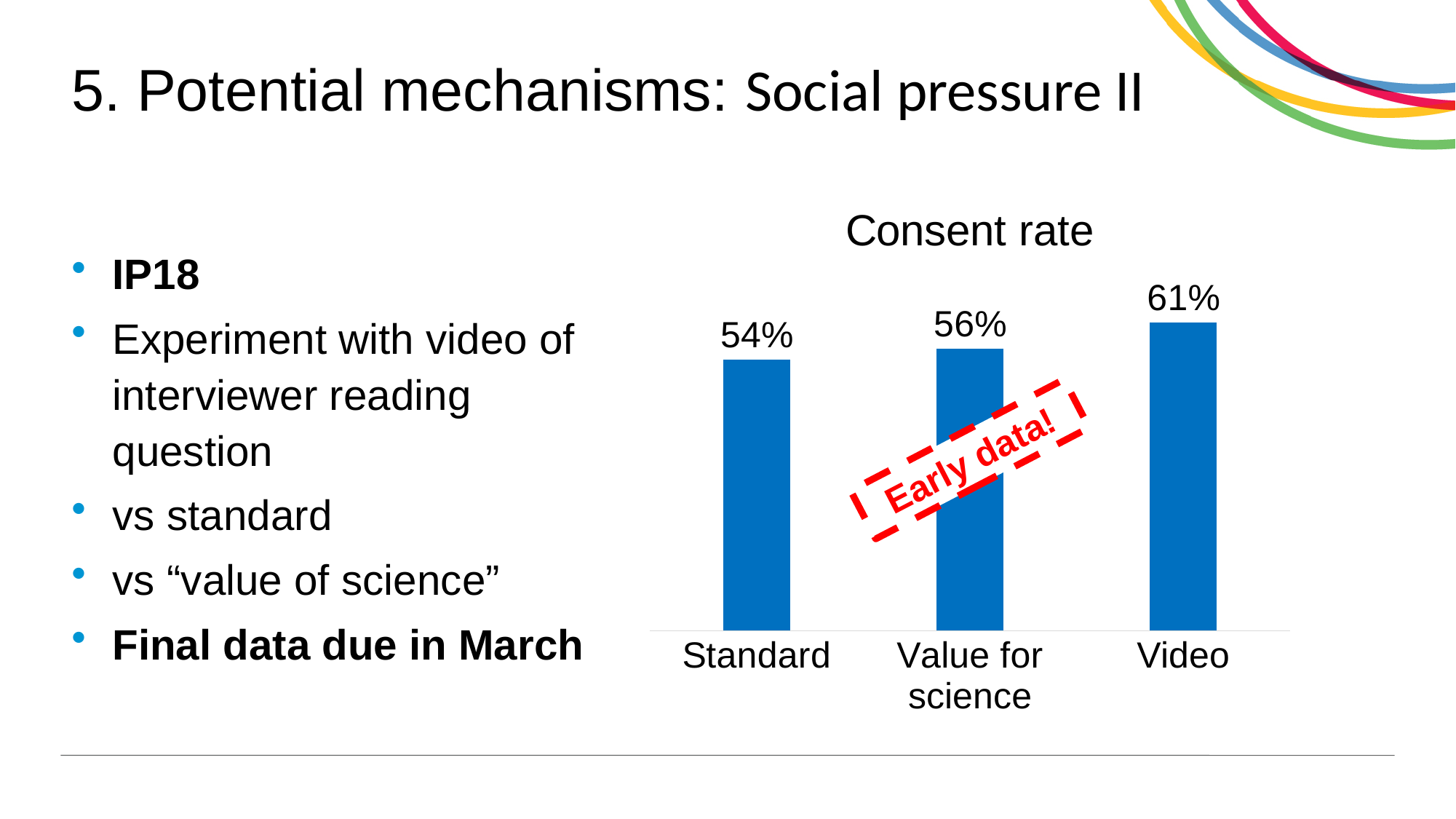
What is the consent rate for Value for science? 56% What is the difference in consent rate between Value for science and Standard? 2% Which category has the highest consent rate? Video Which category has the lowest consent rate? Standard How many categories are shown in the chart? 3 Which has a higher consent rate, Video or Value for science? Video Do the consent rates rise or fall from Standard to Video along the x axis? Rise What kind of chart is shown on the slide? Bar chart What is the consent rate for Standard? 54% What is the difference in consent rate between Video and Standard? 7% What is the consent rate for Video? 61% What is the title of the chart? Consent rate